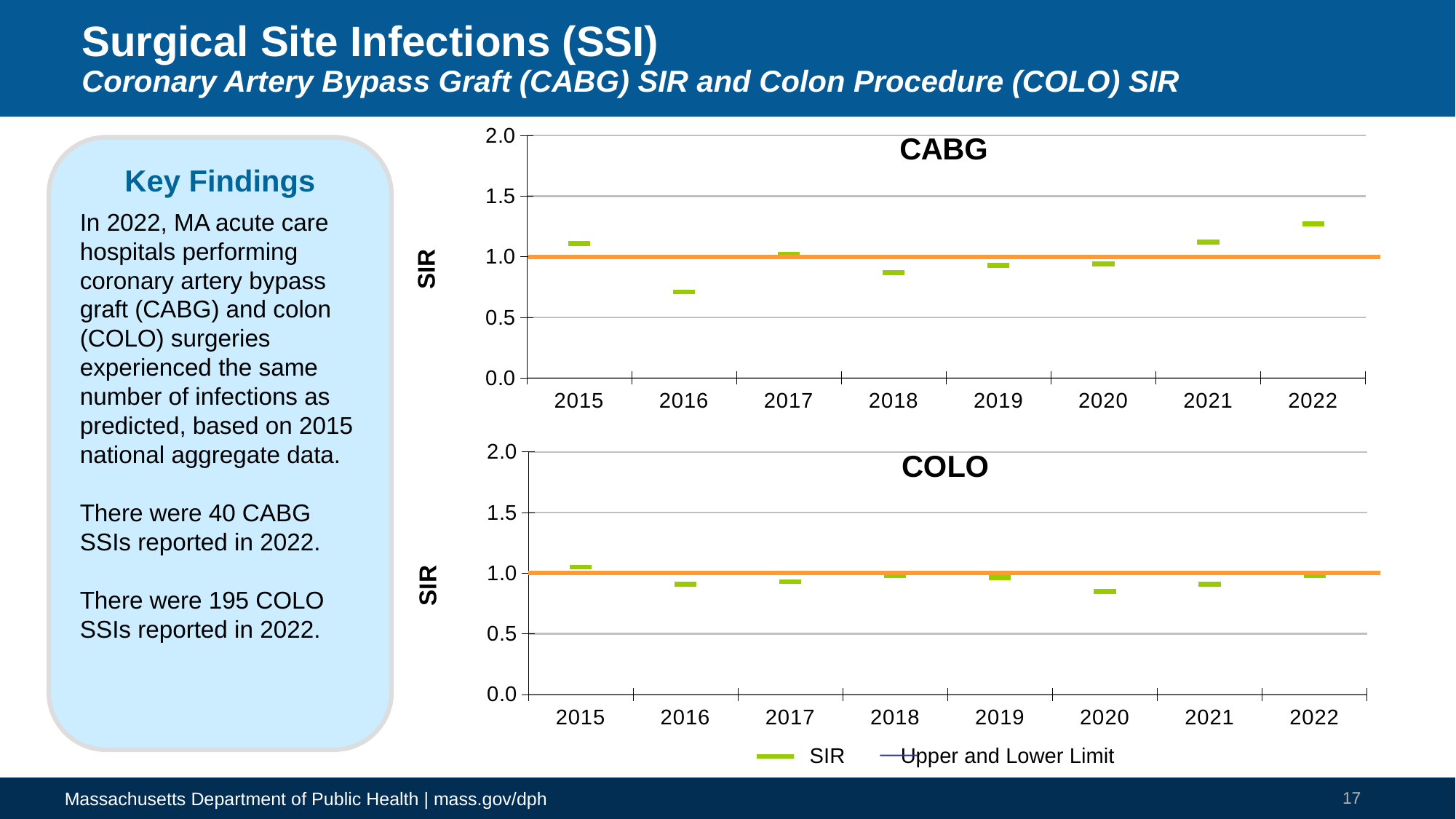
What is the label on the y axis of the CABG chart? SIR How many years are plotted on the x axis of the CABG chart? 8 In the CABG chart, which year has the lowest SIR value? 2016 In the CABG chart, which year has the highest SIR value? 2022 In the COLO chart, which year has the highest SIR value? 2015 In the CABG chart, is the SIR value for 2022 greater or less than 1.0? greater In the COLO chart, is the SIR value for 2020 greater or less than 1.0? less In the CABG chart, which year has a larger SIR value, 2016 or 2021? 2021 In the COLO chart, which year has the lowest SIR value? 2020 In the CABG chart, is the SIR value for 2016 greater or less than 1.0? less How many series does the legend below the COLO chart list? 2 In the COLO chart, which year has a larger SIR value, 2015 or 2020? 2015